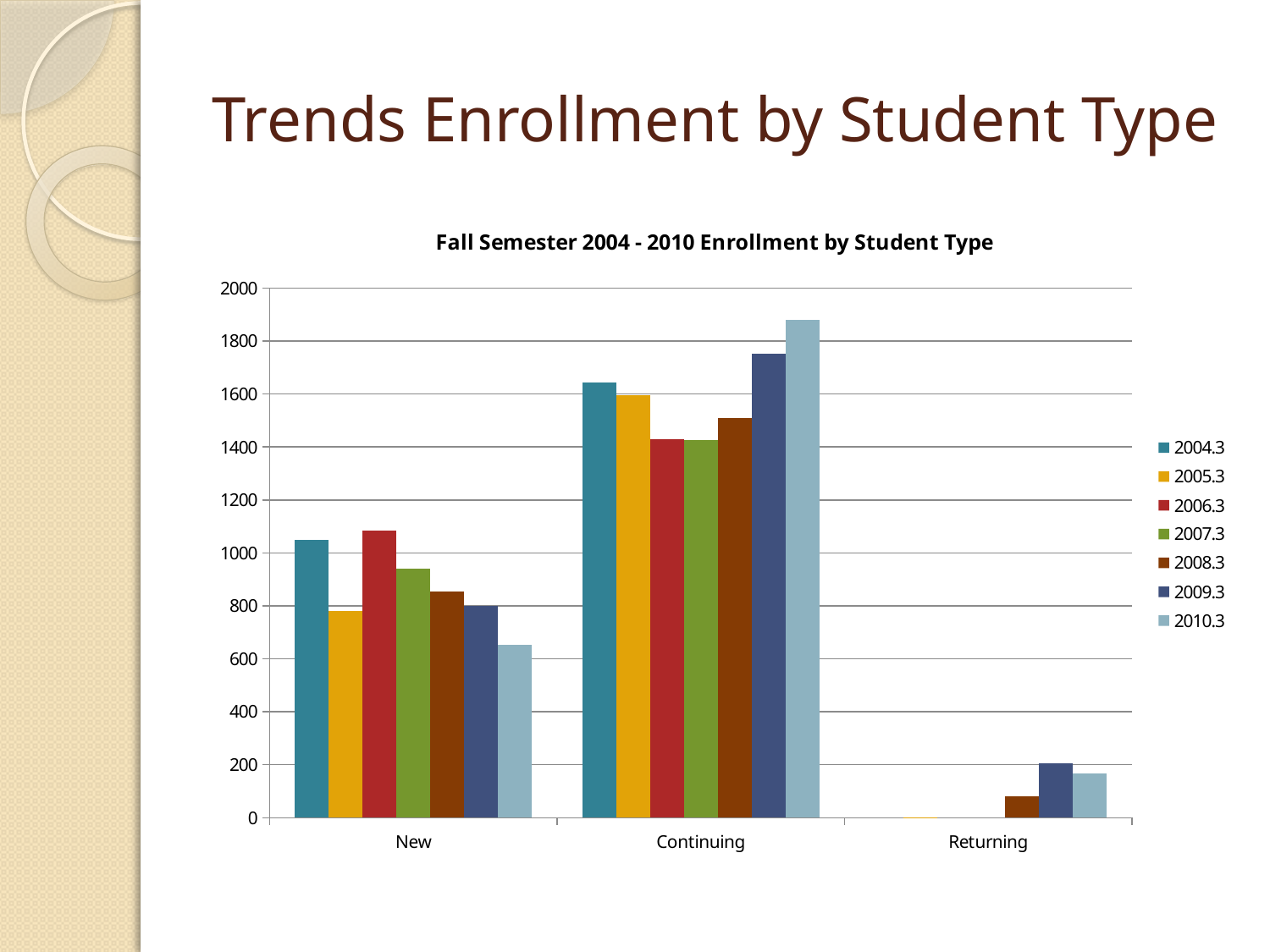
Is the value for 2010.3 in the Continuing category greater or less than 1800? greater How many series does the legend list? 7 Which series has the lowest value in the New category? 2010.3 How many student type categories are shown on the x axis? 3 In the New category, which is larger: the 2005.3 value or the 2007.3 value? 2007.3 Is the value for 2010.3 in the New category greater or less than 800? less In the Continuing category, do the values rise or fall from 2008.3 to 2010.3? rise What is the title of the chart? Fall Semester 2004 - 2010 Enrollment by Student Type What kind of chart is shown on the slide? bar chart Which series has the highest value in the Continuing category? 2010.3 Is the value for 2008.3 in the Returning category greater or less than 200? less Which is larger for 2009.3: the New value or the Continuing value? Continuing